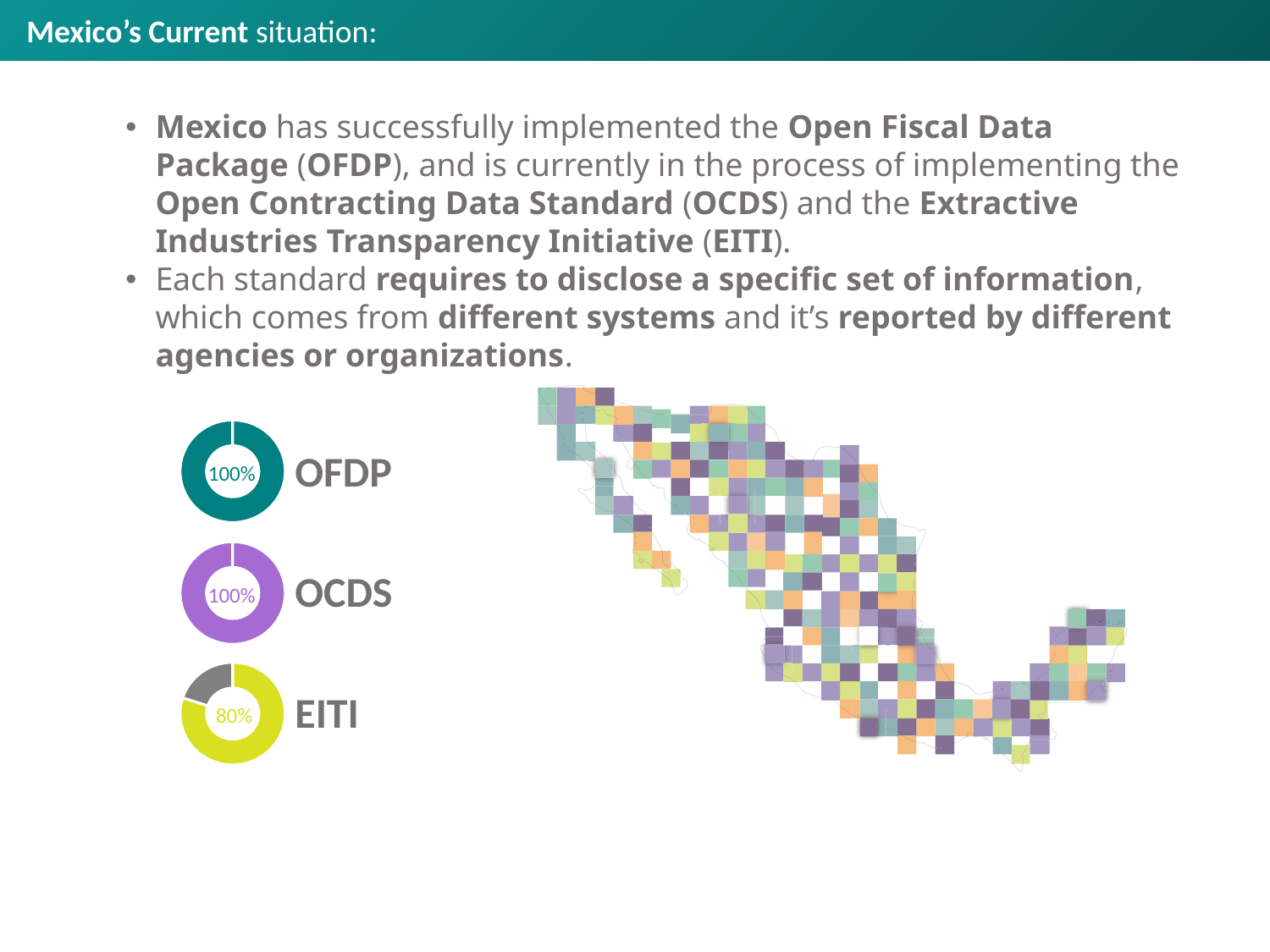
What colour is the filled ring of the OCDS donut chart? Purple What kind of chart is used to show the OFDP, OCDS and EITI percentages? Donut (pie) chart Which is larger, the percentage shown for OFDP or the percentage shown for EITI? OFDP What colour is the filled ring of the OFDP donut chart? Teal (dark green) Which is larger, the percentage shown for OCDS or the percentage shown for EITI? OCDS What value is shown in the OFDP donut chart? 100% What value is shown in the EITI donut chart? 80% In the EITI donut chart, what share of the ring is the grey (unfilled) portion? 20% What value is shown in the OCDS donut chart? 100% Among the three donut charts (OFDP, OCDS, EITI), which standard shows the lowest percentage? EITI How many donut charts are shown on the slide? 3 What is the difference between the OFDP percentage and the EITI percentage? 20%